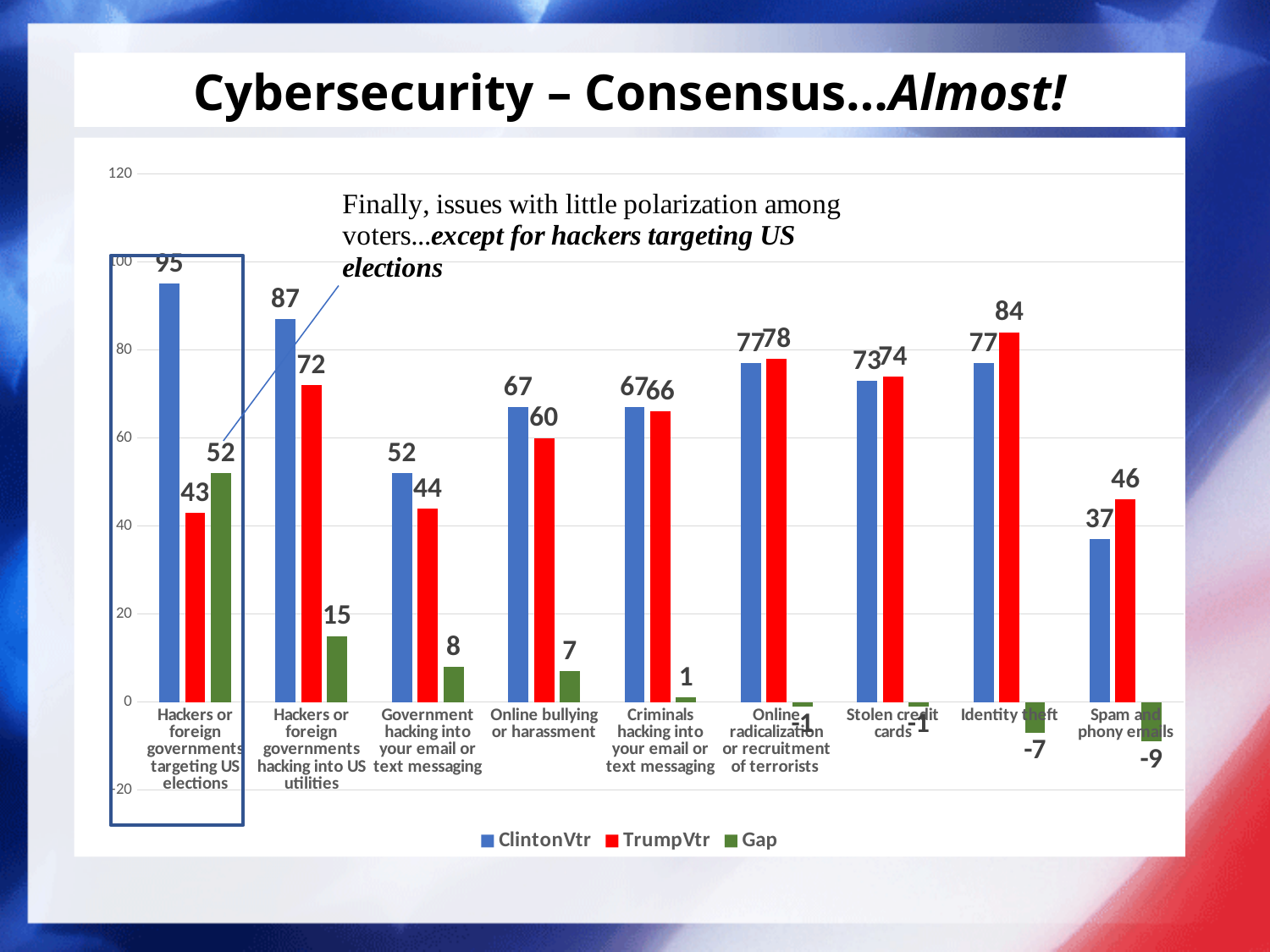
For "Online bullying or harassment", which is larger: the ClintonVtr value or the TrumpVtr value? ClintonVtr What is the TrumpVtr value for "Identity theft"? 84 How many categories are shown on the x axis? 9 Which category has the lowest TrumpVtr value? Spam and phony emails Which series is shown in green in the legend? Gap What is the difference between the ClintonVtr and TrumpVtr values for "Hackers or foreign governments hacking into US utilities"? 15 What is the Gap value for "Government hacking into your email or text messaging"? 8 What is the Gap value for "Spam and phony emails"? -9 What is the ClintonVtr value for "Hackers or foreign governments targeting US elections"? 95 How many series does the legend list? 3 Which category has the highest ClintonVtr value? Hackers or foreign governments targeting US elections What kind of chart is shown on the slide? Bar chart